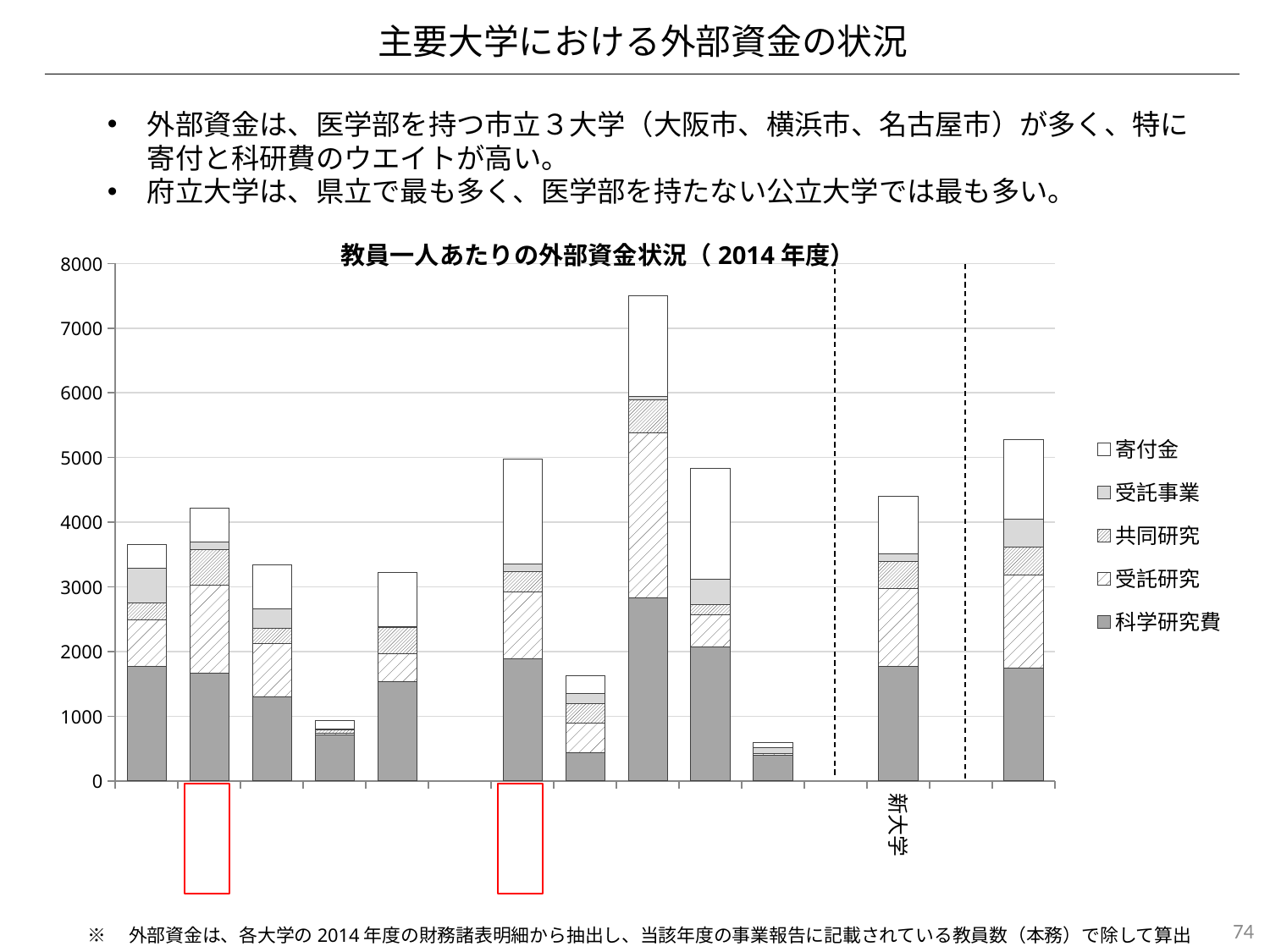
Which series has the smallest segment in the 新大学 bar? 受託事業 How many bars are plotted in the chart? 12 How many series does the legend of the chart list? 5 Which series is shown at the bottom of each stacked bar in the chart? 科学研究費 Is the 科学研究費 value for 新大学 greater or less than 2000? less What kind of chart is shown on the slide? Stacked bar chart Is the total value of the 新大学 bar greater or less than 5000? less What is the title of the chart? 教員一人あたりの外部資金状況（2014年度） Is the total value of the 新大学 bar greater or less than 4000? greater Which is taller, the 新大学 bar or the rightmost bar in the chart? The rightmost bar Which series has the largest segment in the 新大学 bar? 科学研究費